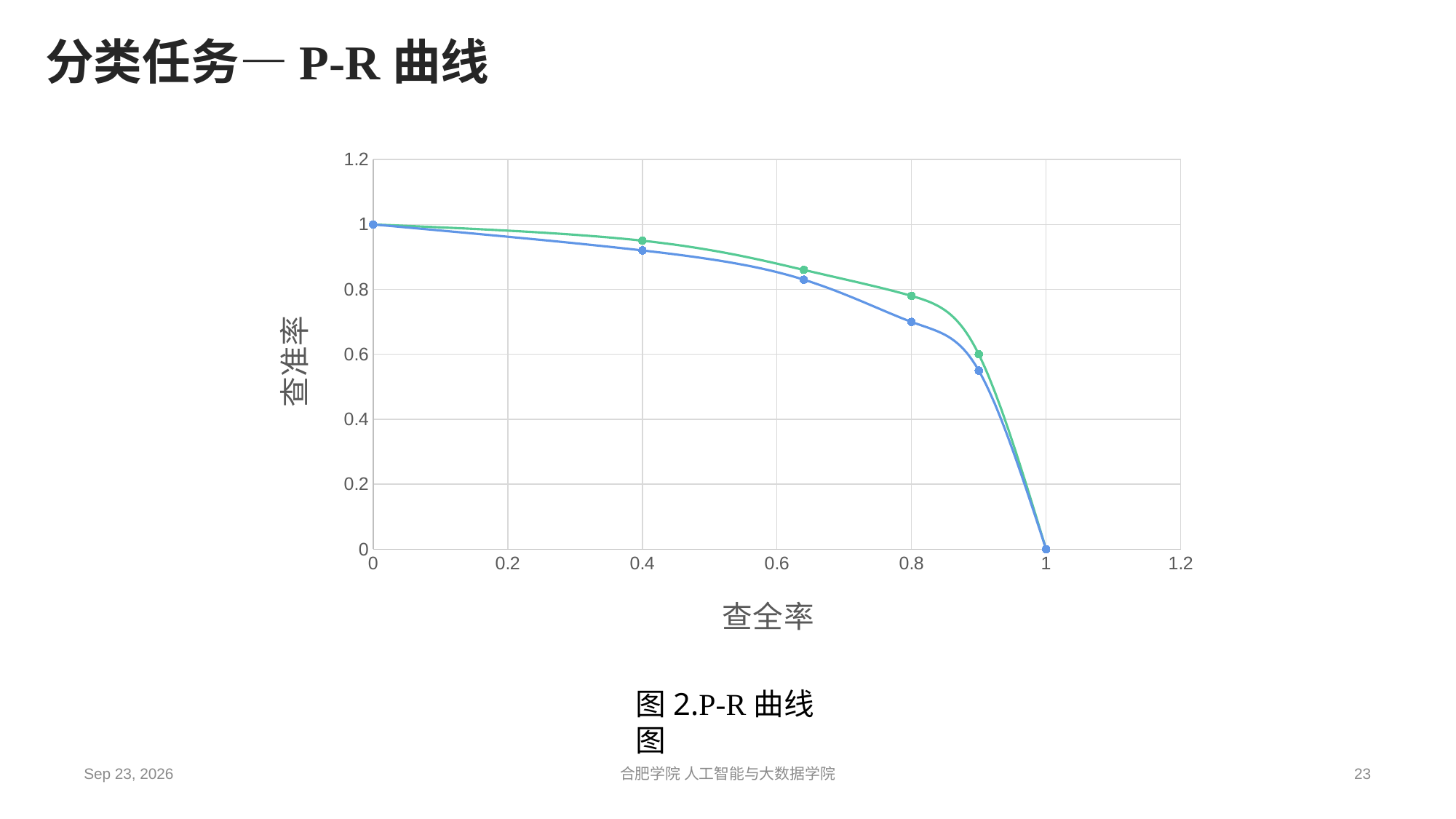
What kind of chart is shown on the slide? line chart At 查全率 = 0.8, which line has the higher 查准率 value, the blue line or the green line? green line Is the value of the blue line at 查全率 = 0.8 greater or less than 0.6? greater Do the plotted values rise or fall as 查全率 increases along the x axis? fall Is the value of the green line at 查全率 = 0.4 greater or less than 0.8? greater How many data points are marked on the blue line? 6 What is the 查准率 value of the curves at 查全率 = 0? 1 What is the 查准率 value of the curves at 查全率 = 1? 0 Is the value of the blue line at 查全率 = 0.8 greater or less than 0.8? less What is the label of the x axis of the chart? 查全率 What is the label of the y axis of the chart? 查准率